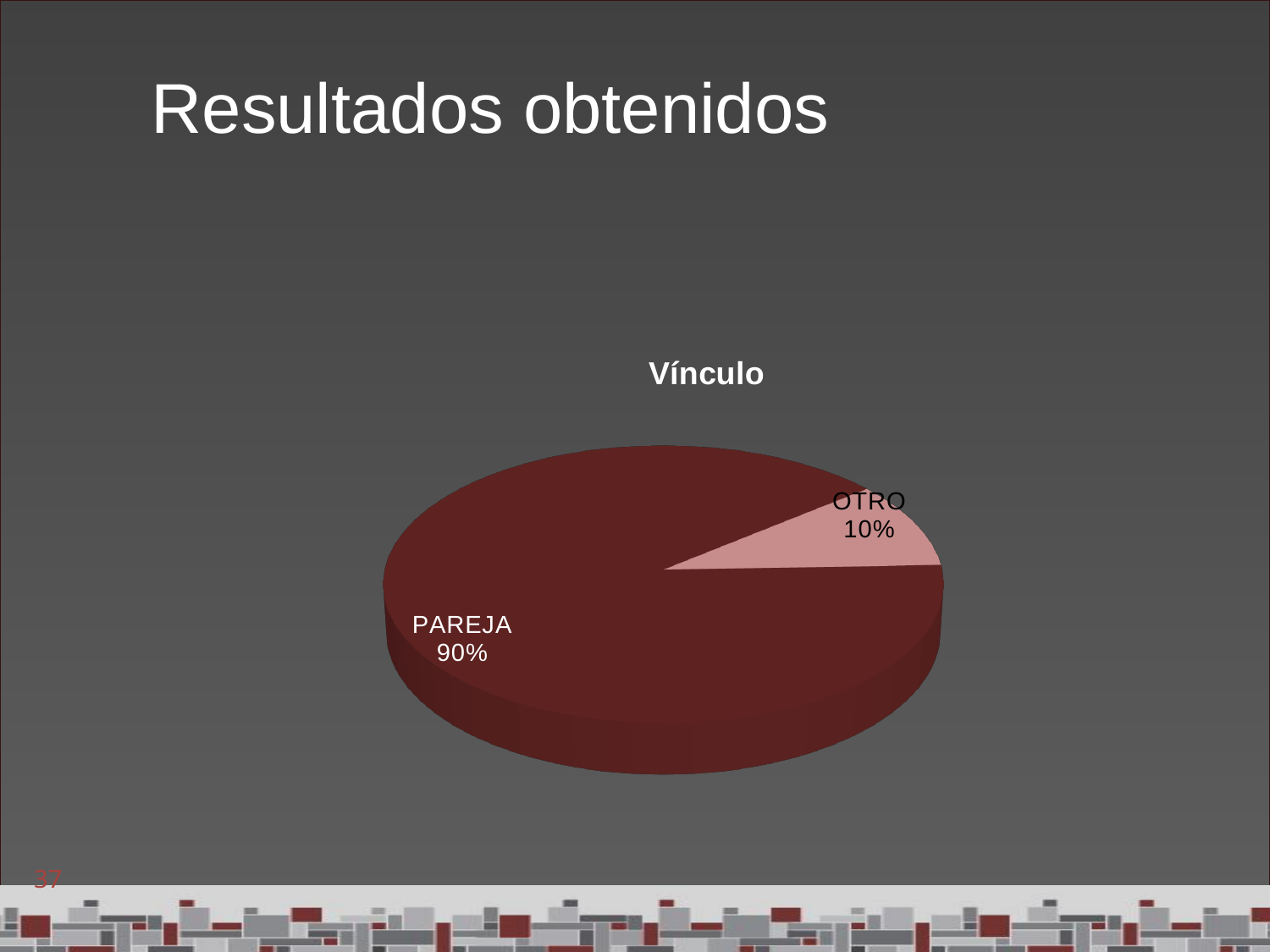
What percentage does the OTRO slice represent? 10% How many slices does the pie chart have? 2 What is the title of the chart? Vínculo Which category has the largest share of the pie? PAREJA What colour is the PAREJA slice? dark red What kind of chart is shown on the slide? pie chart Which category has the smallest share of the pie? OTRO What share of the pie does OTRO take? 10% What is the difference in percentage points between PAREJA and OTRO? 80 Which is larger, the share for PAREJA or the share for OTRO? PAREJA What percentage does the PAREJA slice represent? 90%